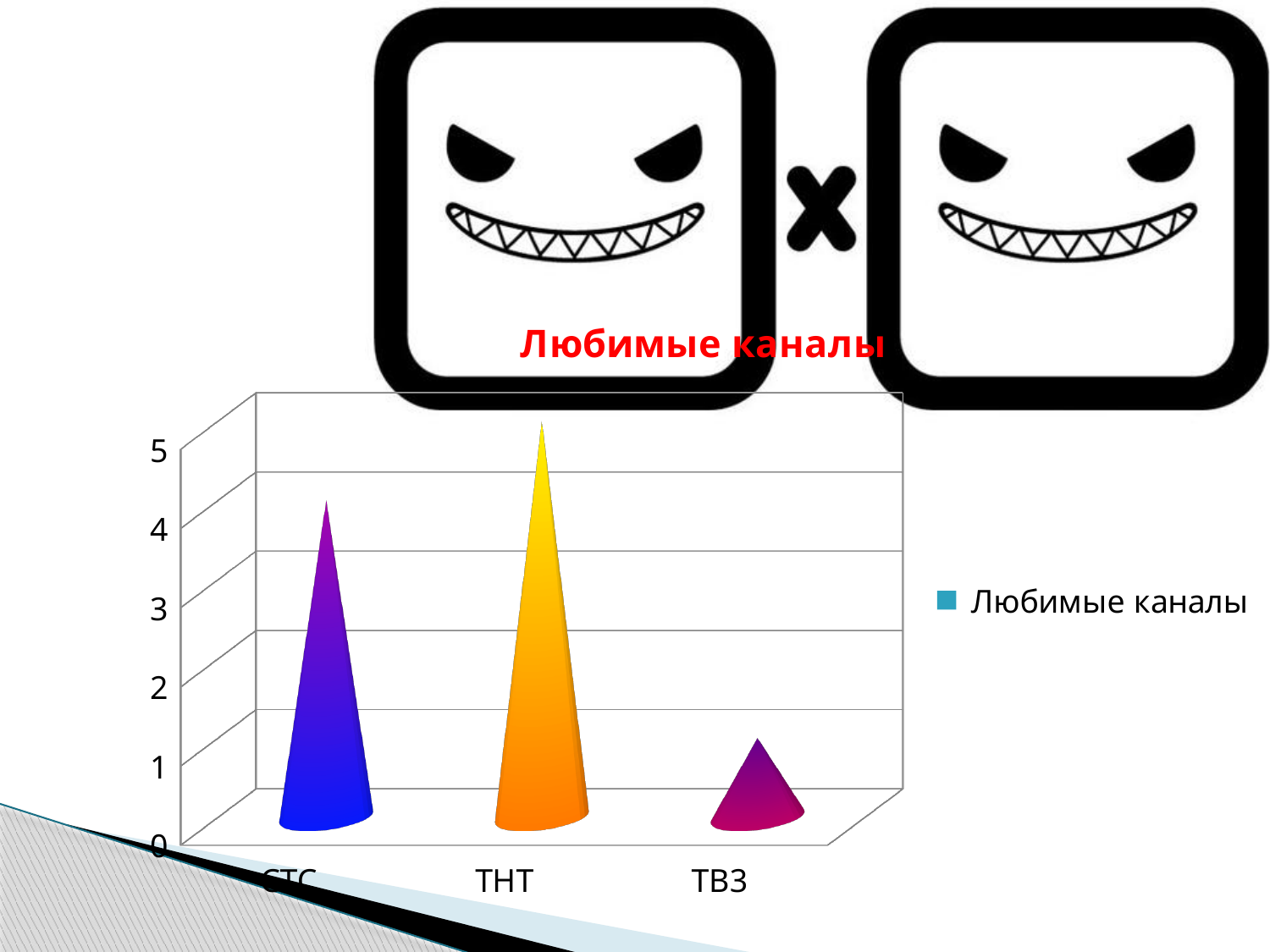
Which has a larger value, СТС or ТВ3? СТС Which channel has the highest value in the chart? ТНТ What is the title of the chart? Любимые каналы Is the value for ТВ3 greater or less than 2? less How many categories are shown on the x axis of the chart? 3 What kind of chart is shown on the slide? bar chart Which has a larger value, ТНТ or СТС? ТНТ Is the value for ТНТ greater or less than 3? greater Is the value for СТС greater or less than 2? greater How many series does the legend list? 1 Which channel has the lowest value in the chart? ТВ3 What is the name of the series shown in the legend? Любимые каналы